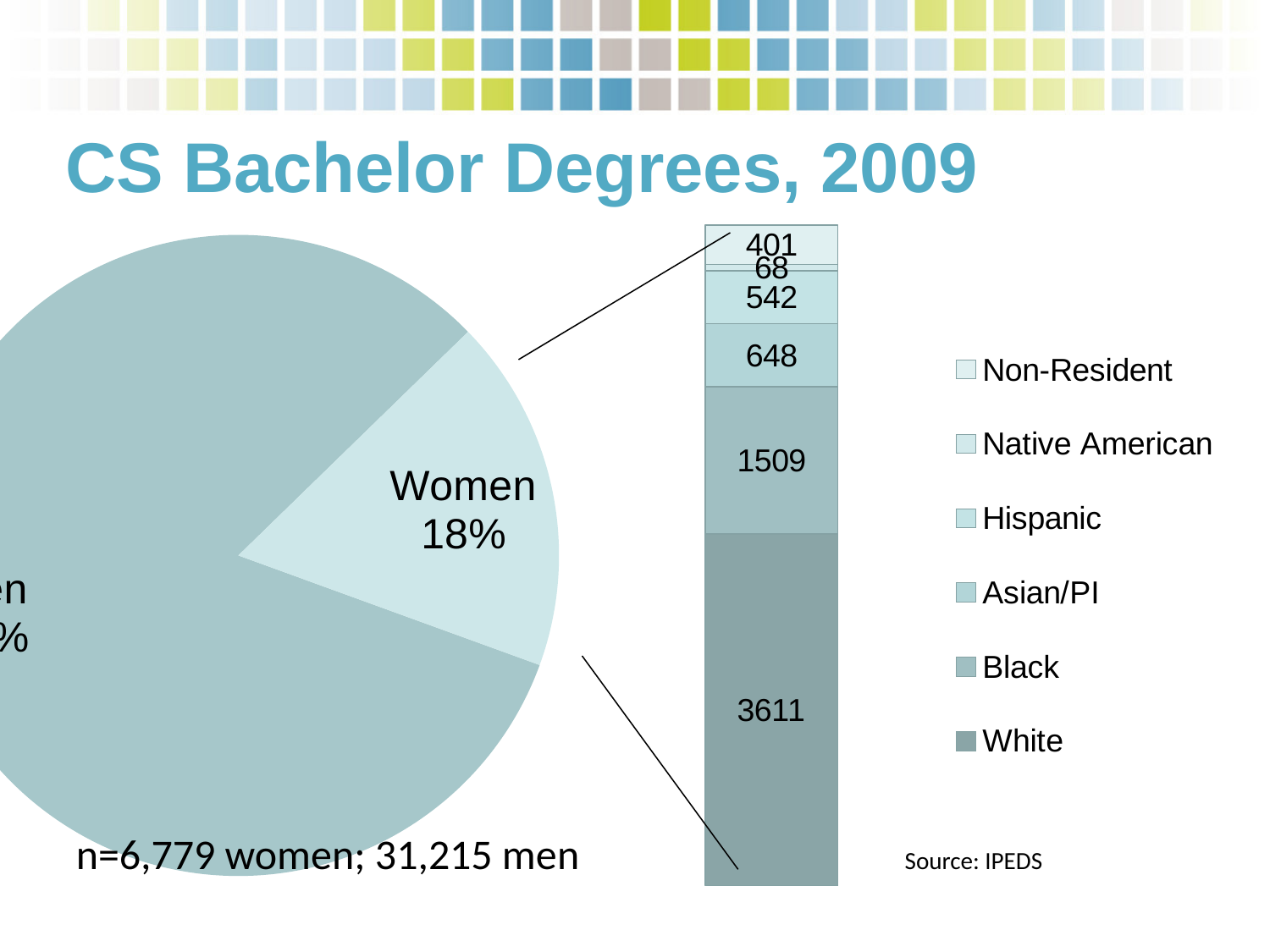
In the stacked bar on the right, which group has the smallest segment? Native American In the stacked bar on the right, what is the value for Native American? 68 In the stacked bar on the right, which group has the largest segment? White In the stacked bar on the right, what is the value for Asian/PI? 648 What kind of chart is shown on the left of the slide? Pie chart In the stacked bar on the right, what is the total of all segments? 6779 In the stacked bar on the right, what is the value for Black? 1509 How many groups does the legend of the stacked bar on the right list? 6 In the stacked bar on the right, what is the value for Hispanic? 542 In the stacked bar on the right, what is the value for White? 3611 In the pie chart on the left, what share of CS bachelor degrees went to women? 18% In the stacked bar on the right, what is the difference between the White and Black values? 2102